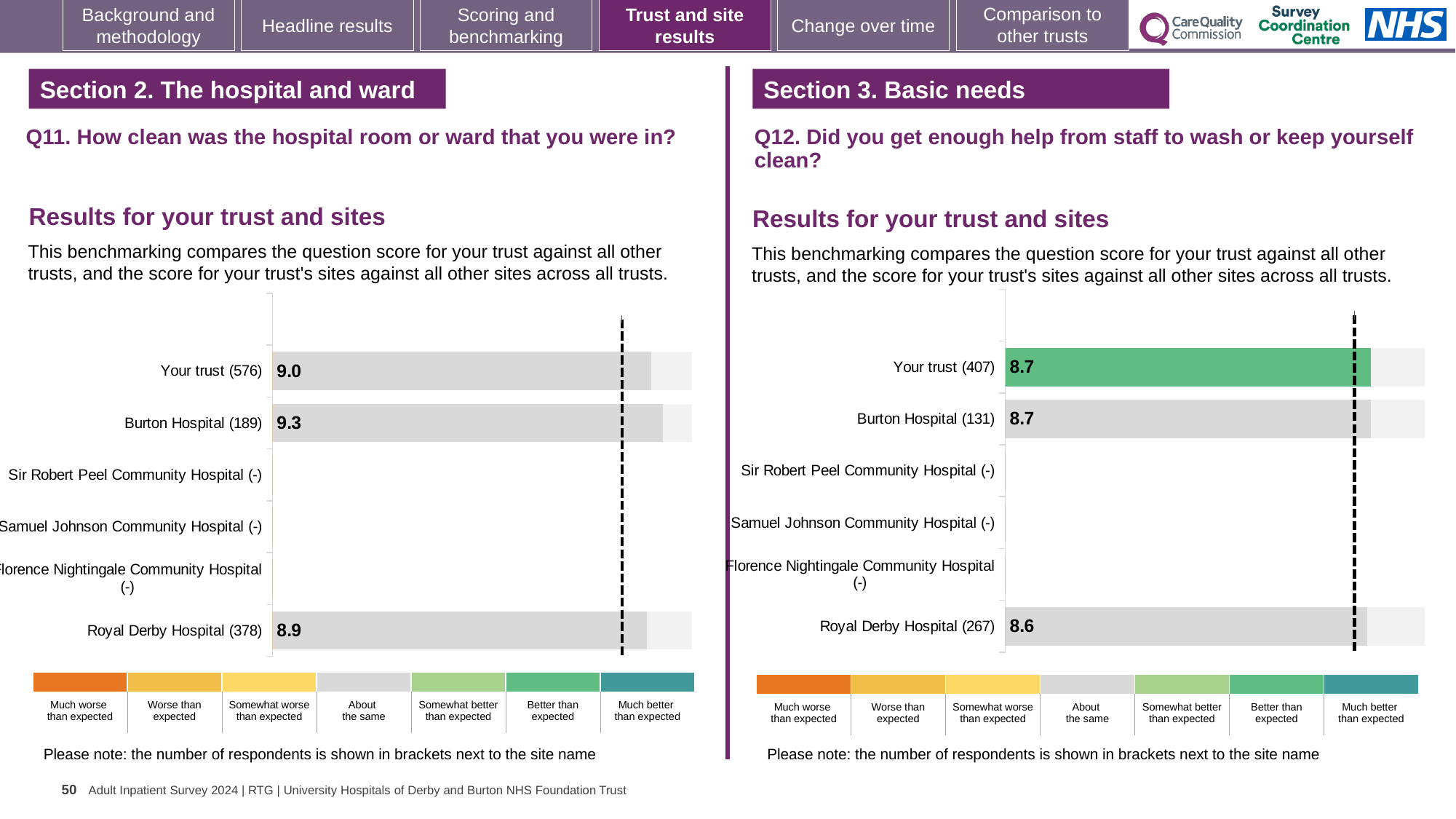
On the Q11 chart (how clean was the hospital room or ward), what is the score for Burton Hospital? 9.3 What kind of chart is used on the Q11 chart (how clean was the hospital room or ward)? Bar chart On the Q11 chart (how clean was the hospital room or ward), which site has the highest score? Burton Hospital On the Q12 chart (help from staff to wash or keep yourself clean), what is the score for Royal Derby Hospital? 8.6 On the Q12 chart (help from staff to wash or keep yourself clean), which benchmark category does the green colour of the Your trust bar correspond to in the legend? Better than expected On the Q12 chart (help from staff to wash or keep yourself clean), how many respondents are shown in brackets for Your trust? 407 On the Q11 chart (how clean was the hospital room or ward), what is the score for Your trust? 9.0 On the Q12 chart (help from staff to wash or keep yourself clean), what is the difference between the Your trust score and the Royal Derby Hospital score? 0.1 On the Q12 chart (help from staff to wash or keep yourself clean), what is the score for Your trust? 8.7 On the Q11 chart (how clean was the hospital room or ward), what is the score for Royal Derby Hospital? 8.9 On the Q11 chart (how clean was the hospital room or ward), what is the difference between the Burton Hospital score and the Royal Derby Hospital score? 0.4 On the Q12 chart (help from staff to wash or keep yourself clean), which is larger: the score for Burton Hospital or the score for Royal Derby Hospital? Burton Hospital